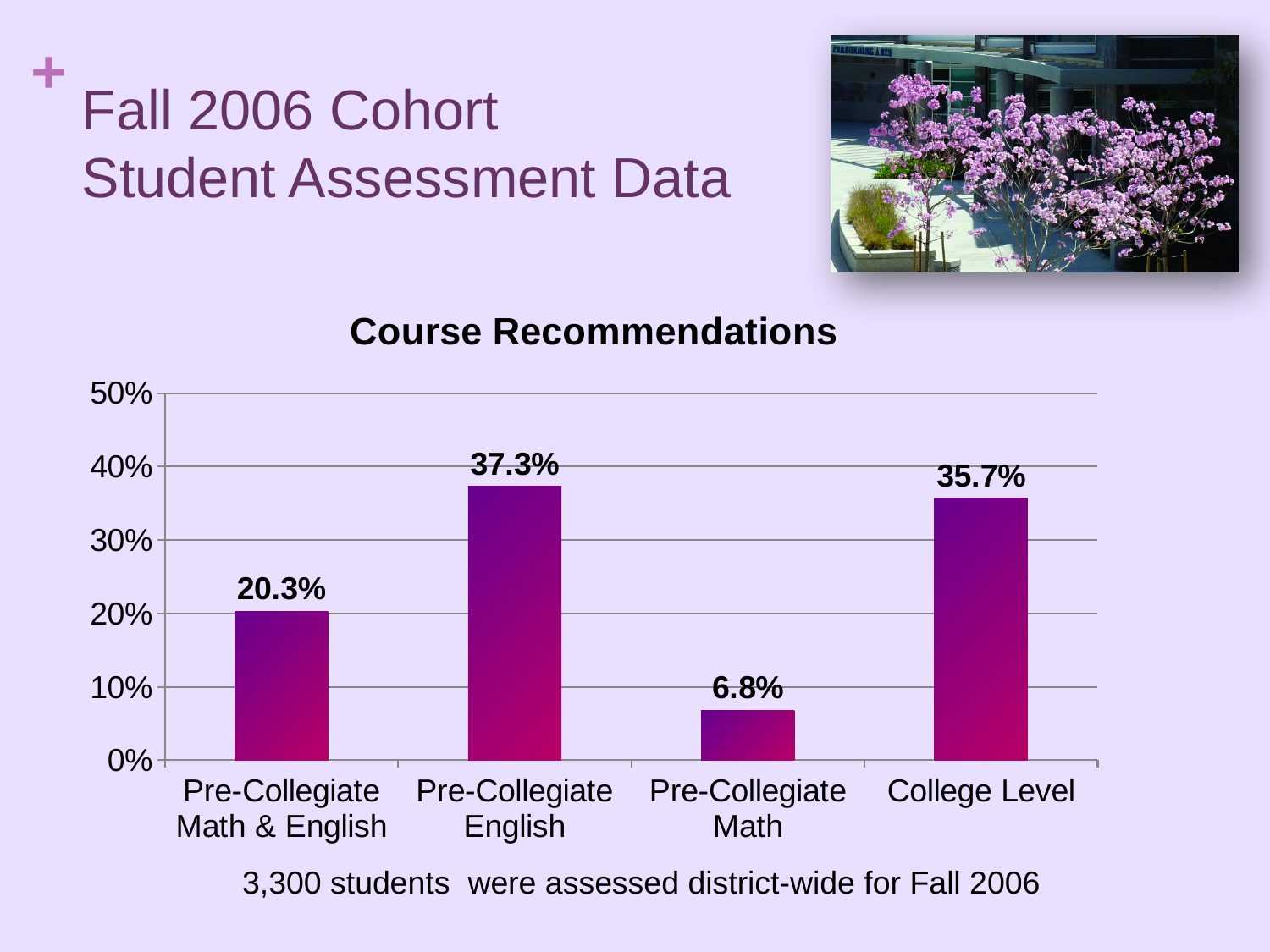
What is the value for Pre-Collegiate Math? 6.8% What is the difference between the values for Pre-Collegiate Math & English and Pre-Collegiate Math? 13.5% What is the value for College Level? 35.7% What kind of chart is shown on the slide? Bar chart What is the value for Pre-Collegiate English? 37.3% Which is larger, the value for Pre-Collegiate Math & English or the value for College Level? College Level How many categories are shown in the chart? 4 What is the title of the chart? Course Recommendations Which category has the lowest value? Pre-Collegiate Math What is the value for Pre-Collegiate Math & English? 20.3% What is the difference between the values for Pre-Collegiate English and College Level? 1.6% Which category has the highest value? Pre-Collegiate English